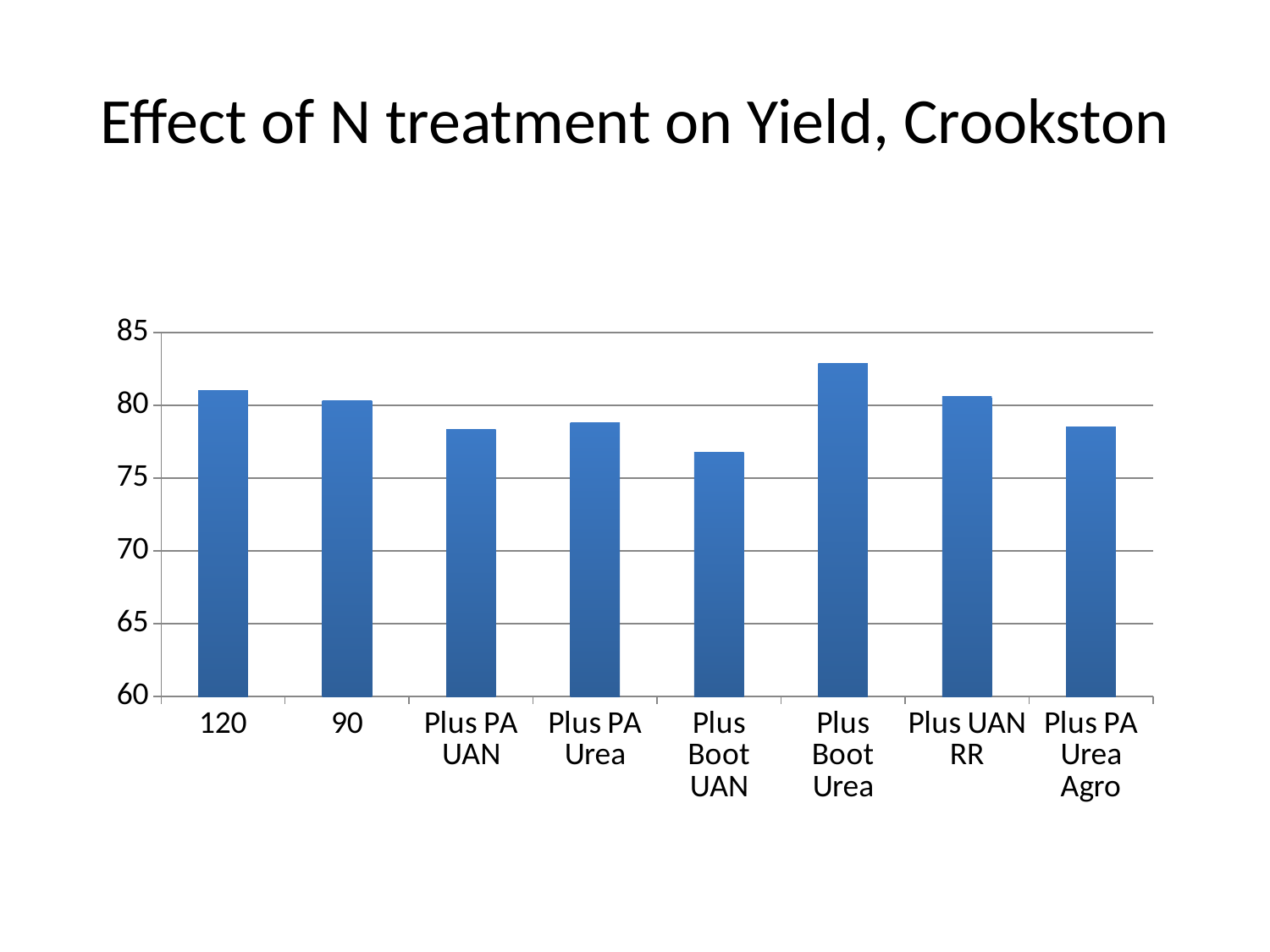
Is the value for Plus PA UAN greater or less than 80? less Is the value for Plus Boot Urea greater or less than 80? greater Is the value for Plus Boot UAN greater or less than 75? greater What is the lowest value shown on the y axis? 60 Which has the larger yield, Plus Boot Urea or Plus Boot UAN? Plus Boot Urea What is the title of the chart? Effect of N treatment on Yield, Crookston Which treatment has the highest yield? Plus Boot Urea What kind of chart is shown on the slide? bar chart How many N treatment categories are shown on the x axis? 8 Which has the larger yield, 120 or Plus PA UAN? 120 Which treatment has the lowest yield? Plus Boot UAN